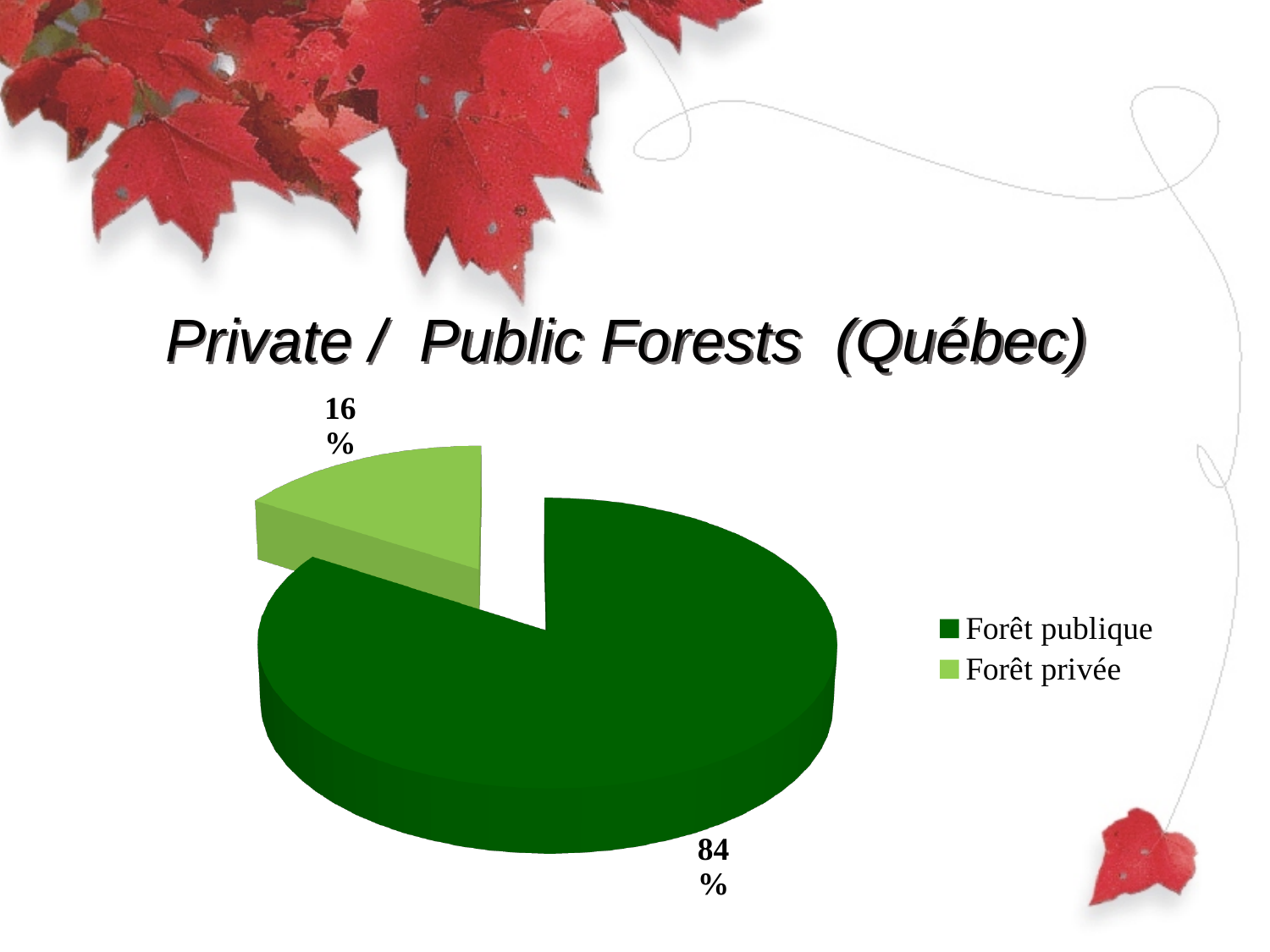
Which category has the smallest slice of the pie? Forêt privée Which legend entry is shown in dark green? Forêt publique Which is larger, the share for Forêt publique or the share for Forêt privée? Forêt publique What is the difference in percentage points between Forêt publique and Forêt privée? 68 How many entries does the legend list? 2 Which category has the largest slice of the pie? Forêt publique What kind of chart is shown on the slide? pie chart What is the title of the slide containing the chart? Private / Public Forests (Québec) What share of the pie does Forêt publique represent? 84% What share of the pie does Forêt privée represent? 16% How many slices does the pie chart have? 2